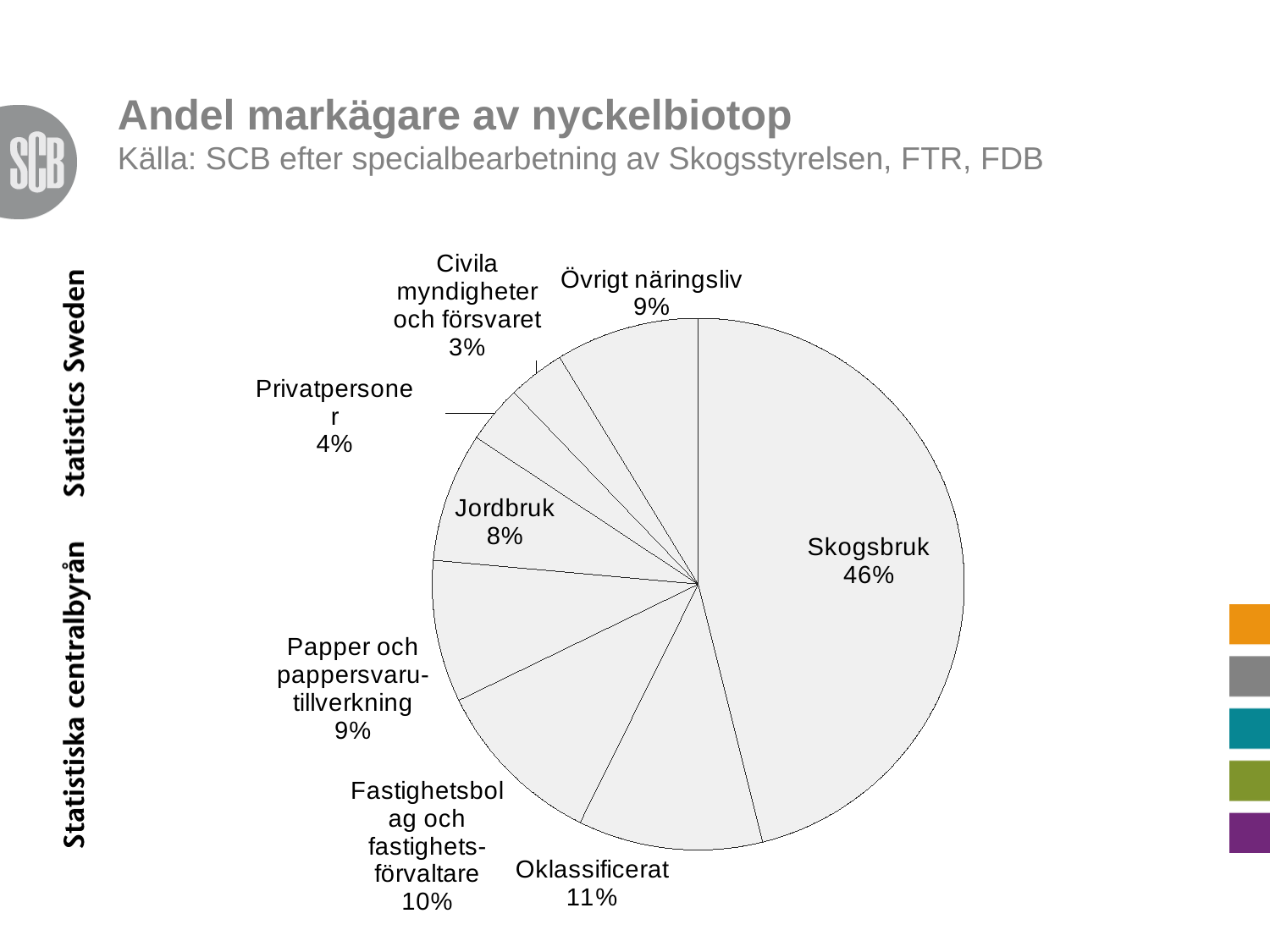
How many slices does the pie chart have? 8 What is the title of the chart on the slide? Andel markägare av nyckelbiotop Which category has the smallest slice of the pie? Civila myndigheter och försvaret What is the difference in percentage points between Skogsbruk and Oklassificerat? 35 What percentage is shown for Jordbruk? 8% What percentage is shown for Privatpersoner? 4% What is the value shown for Oklassificerat? 11% What share of the pie does Skogsbruk have? 46% Which is larger, Fastighetsbolag och fastighetsförvaltare or Jordbruk? Fastighetsbolag och fastighetsförvaltare What kind of chart is shown on the slide? Pie chart What is the value for Civila myndigheter och försvaret? 3% Which category has the largest slice of the pie? Skogsbruk